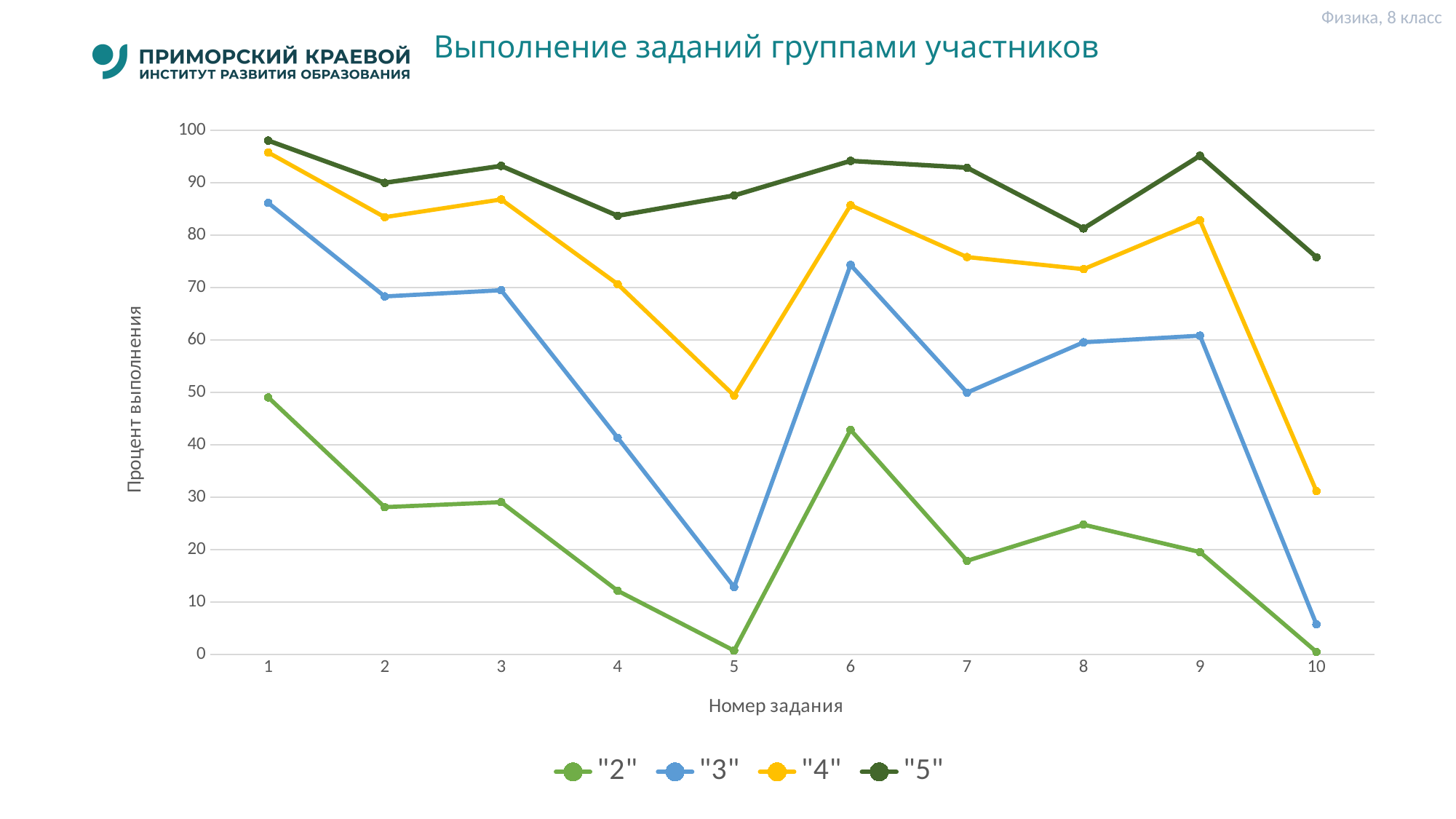
For series "2", at which task number is the value highest? 1 What kind of chart is shown on the slide? line chart At task 5, which series has the higher value, "4" or "3"? "4" How many task numbers are plotted along the x axis? 10 Is the value for series "4" at task 6 greater or less than 80? greater For series "5", at which task number is the value lowest? 10 Is the value for series "2" at task 5 greater or less than 10? less Between task 9 and task 10, does the value for series "3" rise or fall? fall Is the value for series "5" at task 1 greater or less than 90? greater What is the title of the vertical axis? Процент выполнения How many series does the legend list? 4